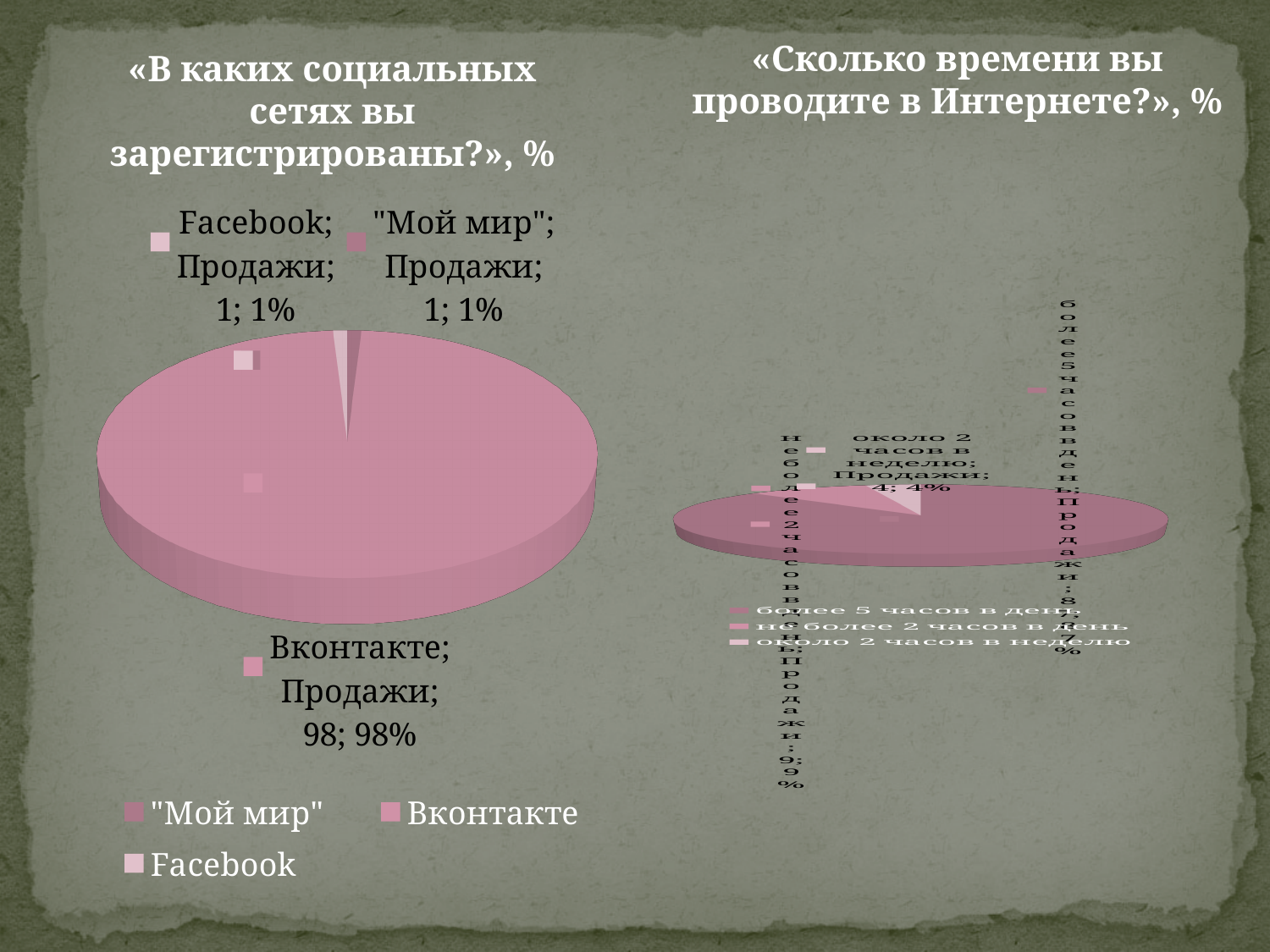
In the right chart, «Сколько времени вы проводите в Интернете?», which is larger: «не более 2 часов в день» or «около 2 часов в неделю»? не более 2 часов в день In the left chart, «В каких социальных сетях вы зарегистрированы?», how many slices does the pie have? 3 In the left chart, «В каких социальных сетях вы зарегистрированы?», what percentage is shown for Вконтакте? 98% In the left chart, «В каких социальных сетях вы зарегистрированы?», how many entries does the legend list? 3 In the right chart, «Сколько времени вы проводите в Интернете?», what is the difference in percentage points between «более 5 часов в день» and «не более 2 часов в день»? 78 What kind of chart is the left chart, «В каких социальных сетях вы зарегистрированы?»? pie chart In the left chart, «В каких социальных сетях вы зарегистрированы?», what is the difference in percentage points between Вконтакте and "Мой мир"? 97 In the right chart, «Сколько времени вы проводите в Интернете?», what percentage is shown for «около 2 часов в неделю»? 4% In the left chart, «В каких социальных сетях вы зарегистрированы?», what percentage is shown for Facebook? 1% In the right chart, «Сколько времени вы проводите в Интернете?», what percentage is shown for «более 5 часов в день»? 87% In the left chart, «В каких социальных сетях вы зарегистрированы?», which social network has the largest slice? Вконтакте In the right chart, «Сколько времени вы проводите в Интернете?», which answer option has the smallest slice? около 2 часов в неделю